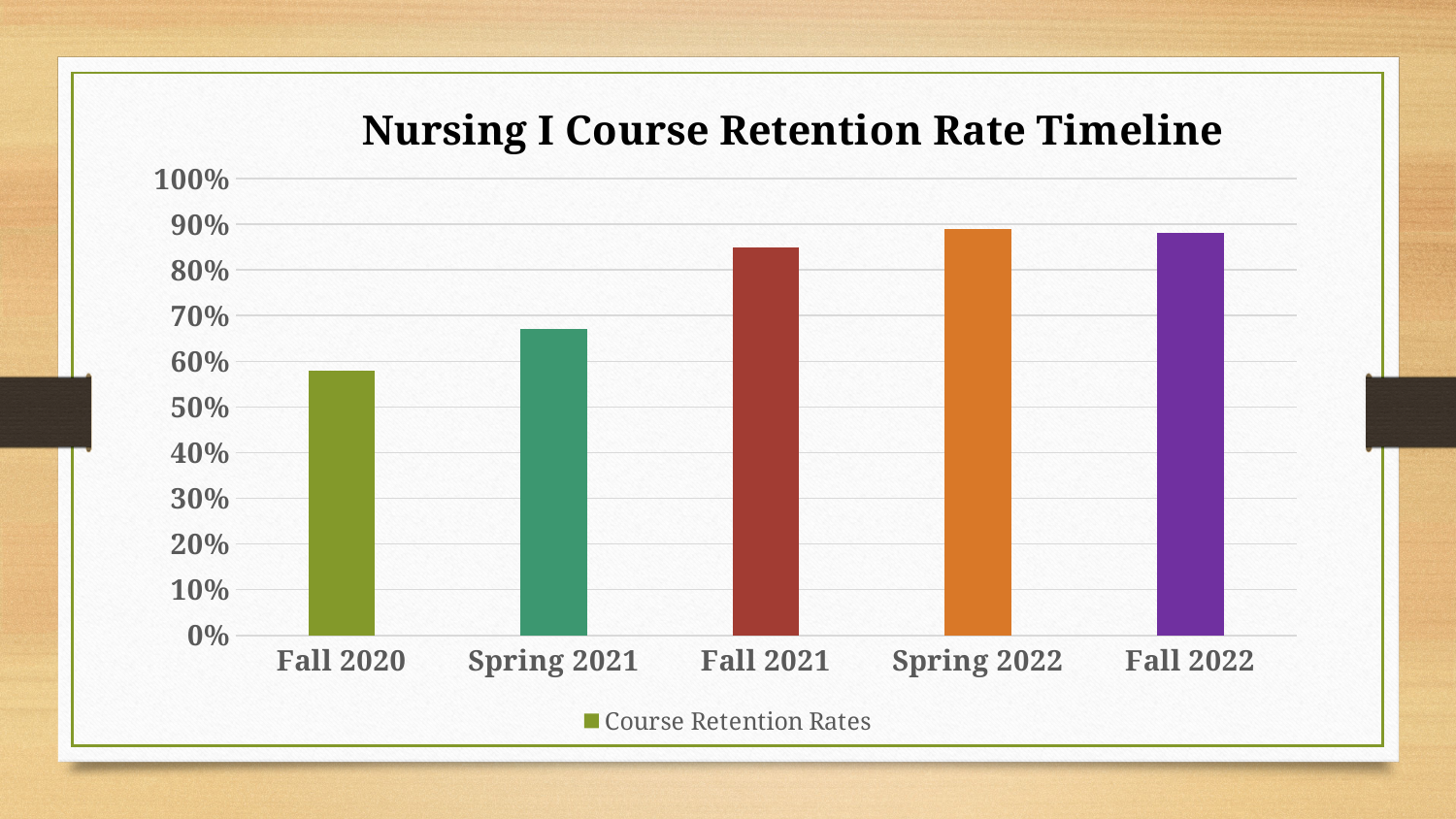
Is the value for Spring 2021 greater or less than 70%? less Do the retention rates generally rise or fall from Fall 2020 to Spring 2022? Rise What is the name of the series listed in the legend? Course Retention Rates Which semester has the lowest course retention rate? Fall 2020 How many series does the legend list? 1 What kind of chart is shown on the slide? Bar chart Is the value for Fall 2021 greater or less than 80%? greater Is the value for Fall 2020 greater or less than 50%? greater What is the title of the chart? Nursing I Course Retention Rate Timeline Which is larger, the retention rate for Spring 2021 or for Fall 2021? Fall 2021 How many semesters are shown on the x axis of the chart? 5